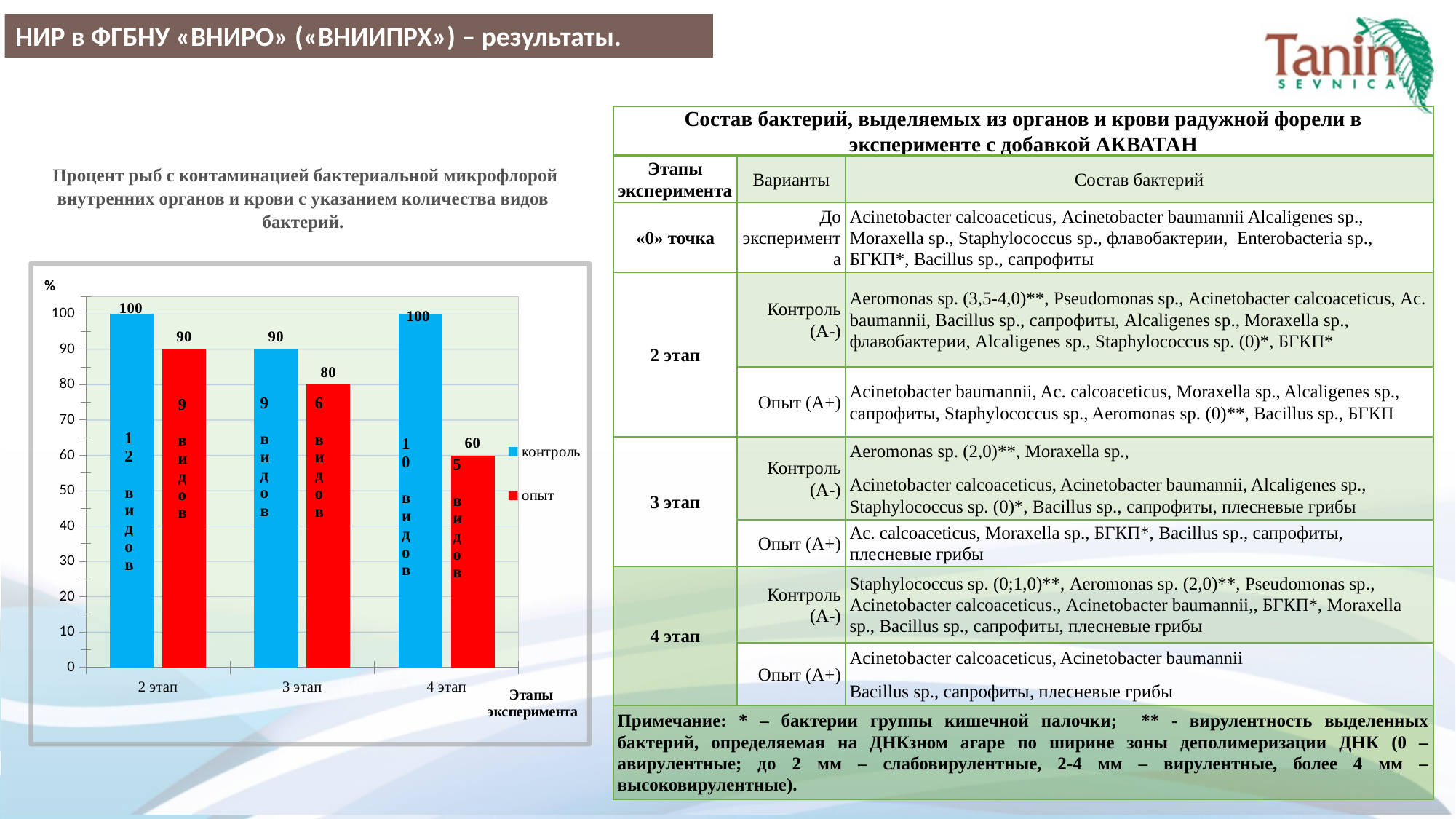
What is the value for контроль at 2 этап? 100 What is the difference between контроль and опыт at 2 этап? 10 What is the difference between контроль and опыт at 4 этап? 40 How many stages (categories) are shown on the x axis? 3 What is the value for контроль at 3 этап? 90 What is the value for опыт at 3 этап? 80 What is the value for опыт at 4 этап? 60 Do the опыт values rise or fall from 2 этап to 4 этап? fall At which stage is the опыт value lowest? 4 этап Which is larger at 3 этап, контроль or опыт? контроль What kind of chart is shown on the slide? bar chart How many series does the legend list? 2